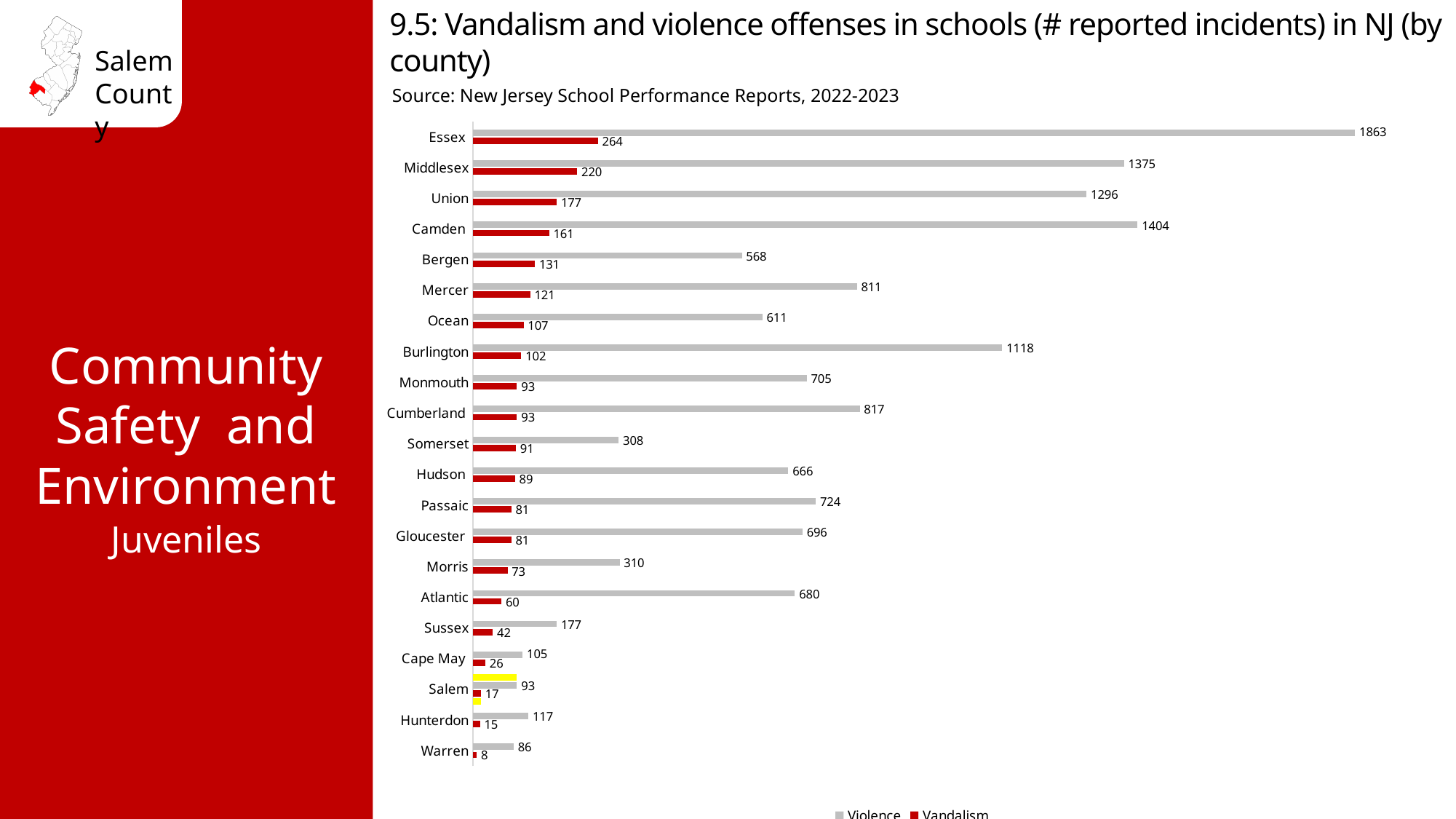
Do the vandalism values rise or fall going from Essex at the top to Warren at the bottom? Fall How many series does the legend list? 2 Which county has the highest number of reported violence incidents? Essex What is the number of reported vandalism incidents for Salem County? 17 What is the number of reported violence incidents for Burlington County? 1118 What kind of chart is shown on the slide? Bar chart Which county has the lowest number of reported vandalism incidents? Warren Which county has more reported violence incidents, Camden or Union? Camden What is the number of reported violence incidents for Salem County? 93 What is the difference between the violence incidents in Essex and Middlesex? 488 What is the difference between violence and vandalism incidents in Salem County? 76 How many counties are shown in the chart? 21